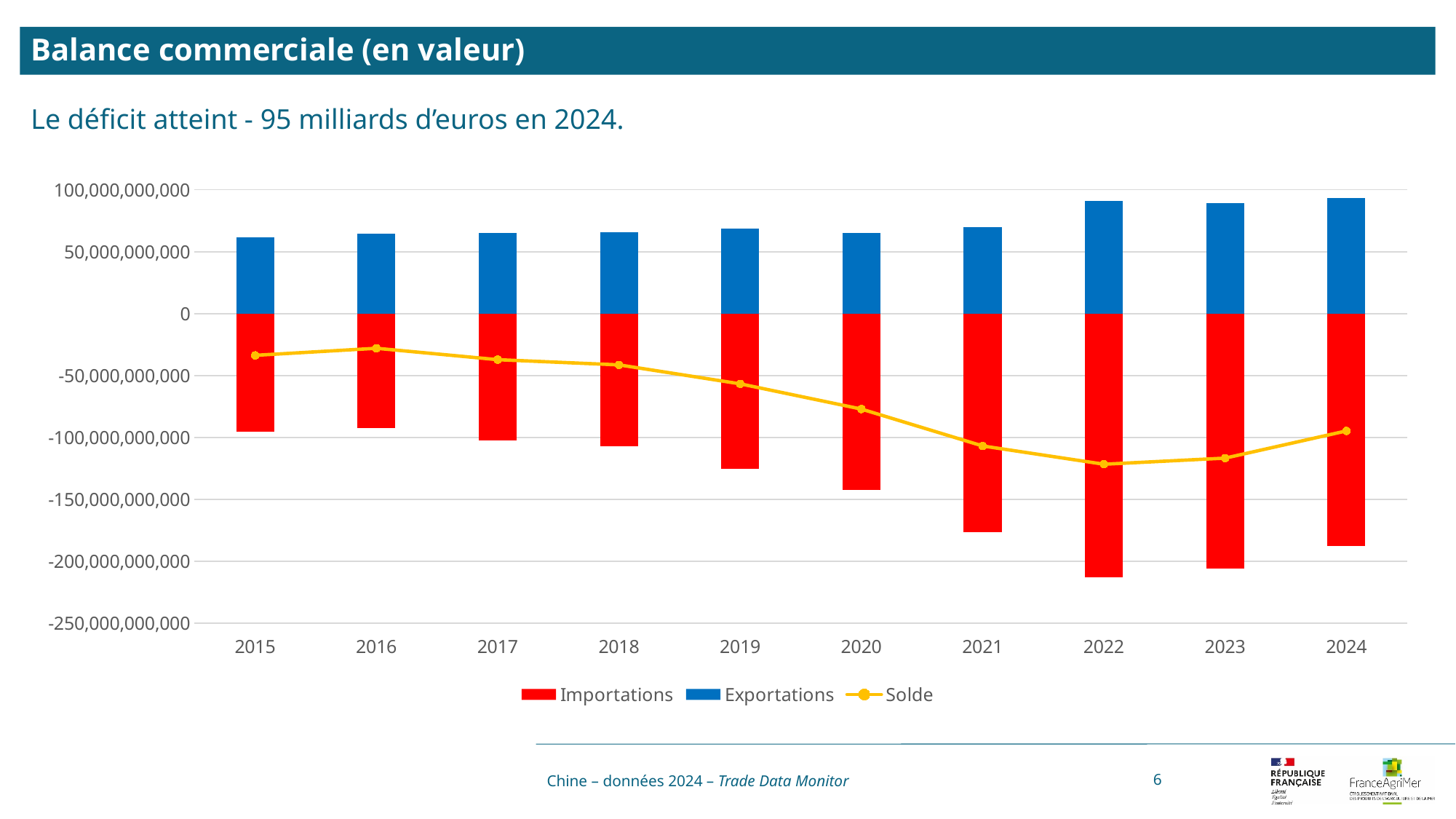
What kind of chart is shown on the slide? A bar chart combined with a line How many years are shown on the x axis of the chart? 10 Which year has the larger Exportations value, 2021 or 2022? 2022 Does the Solde line rise or fall from 2016 to 2022? Falls Is the Solde value for 2022 greater or less than -100,000,000,000? less What colour are the Importations bars? Red Is the Importations value for 2022 greater or less than -200,000,000,000? less Is the Exportations value for 2024 greater or less than 50,000,000,000? greater How many series does the chart legend list? 3 Which series are listed in the chart legend? Importations, Exportations, Solde In which year is the Solde line at its lowest point? 2022